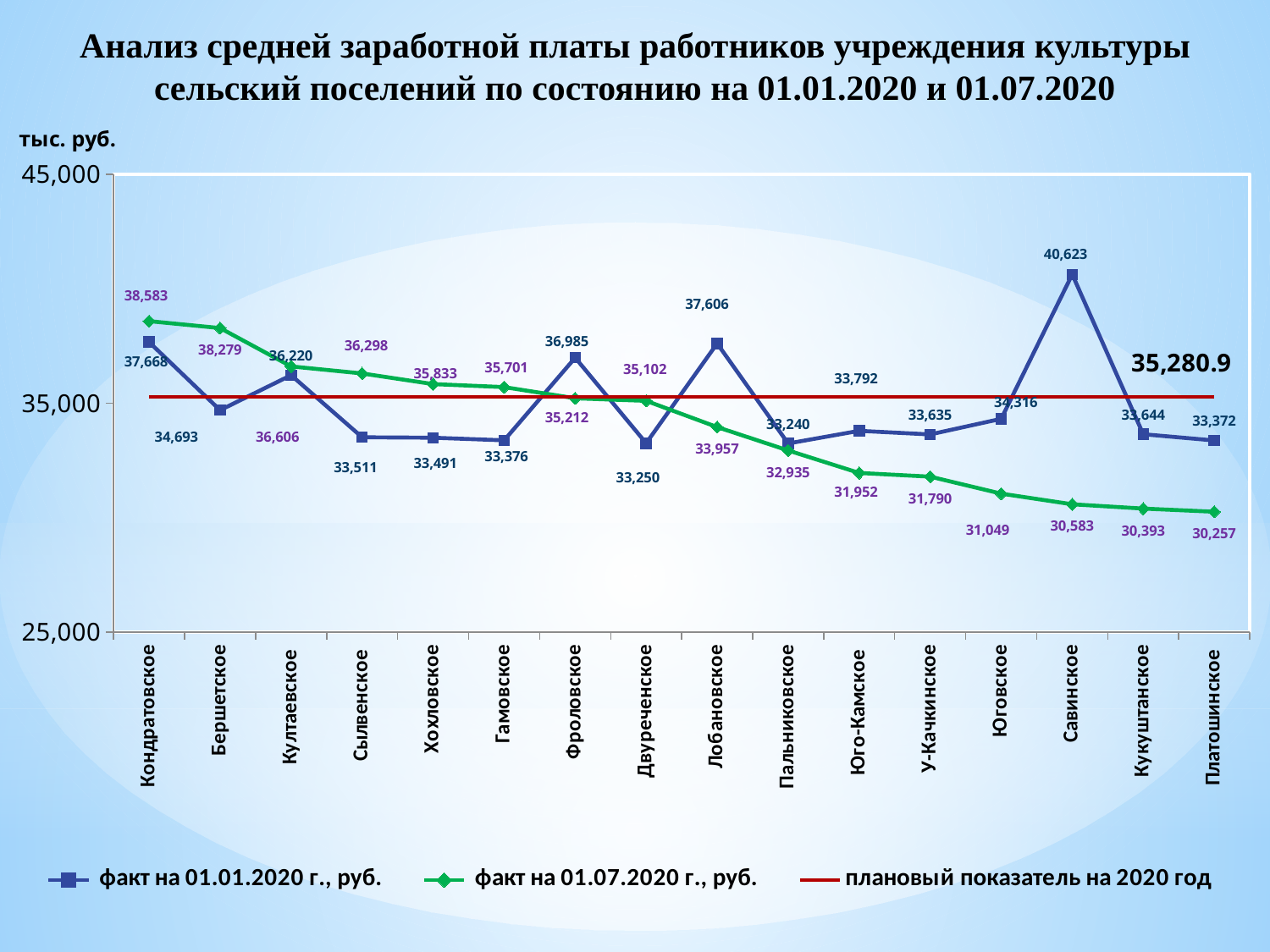
What is the value for Савинское in the series 'факт на 01.01.2020 г., руб.'? 40,623 How many settlements are plotted along the x axis? 16 What is the difference between the 01.01.2020 value and the 01.07.2020 value for Савинское? 10,040 What kind of chart is shown on the slide? line chart Which settlement has the highest value in the series 'факт на 01.01.2020 г., руб.'? Савинское What is the value of the planned indicator for 2020 (плановый показатель на 2020 год)? 35,280.9 What is the value for Платошинское in the series 'факт на 01.07.2020 г., руб.'? 30,257 What is the difference between the 01.01.2020 value and the 01.07.2020 value for Лобановское? 3,649 Does the series 'факт на 01.07.2020 г., руб.' generally rise or fall from left to right along the x axis? fall Which settlement has the lowest value in the series 'факт на 01.07.2020 г., руб.'? Платошинское How many series does the legend list? 3 For Кондратовское, which is larger: the value on 01.01.2020 or the value on 01.07.2020? 01.07.2020